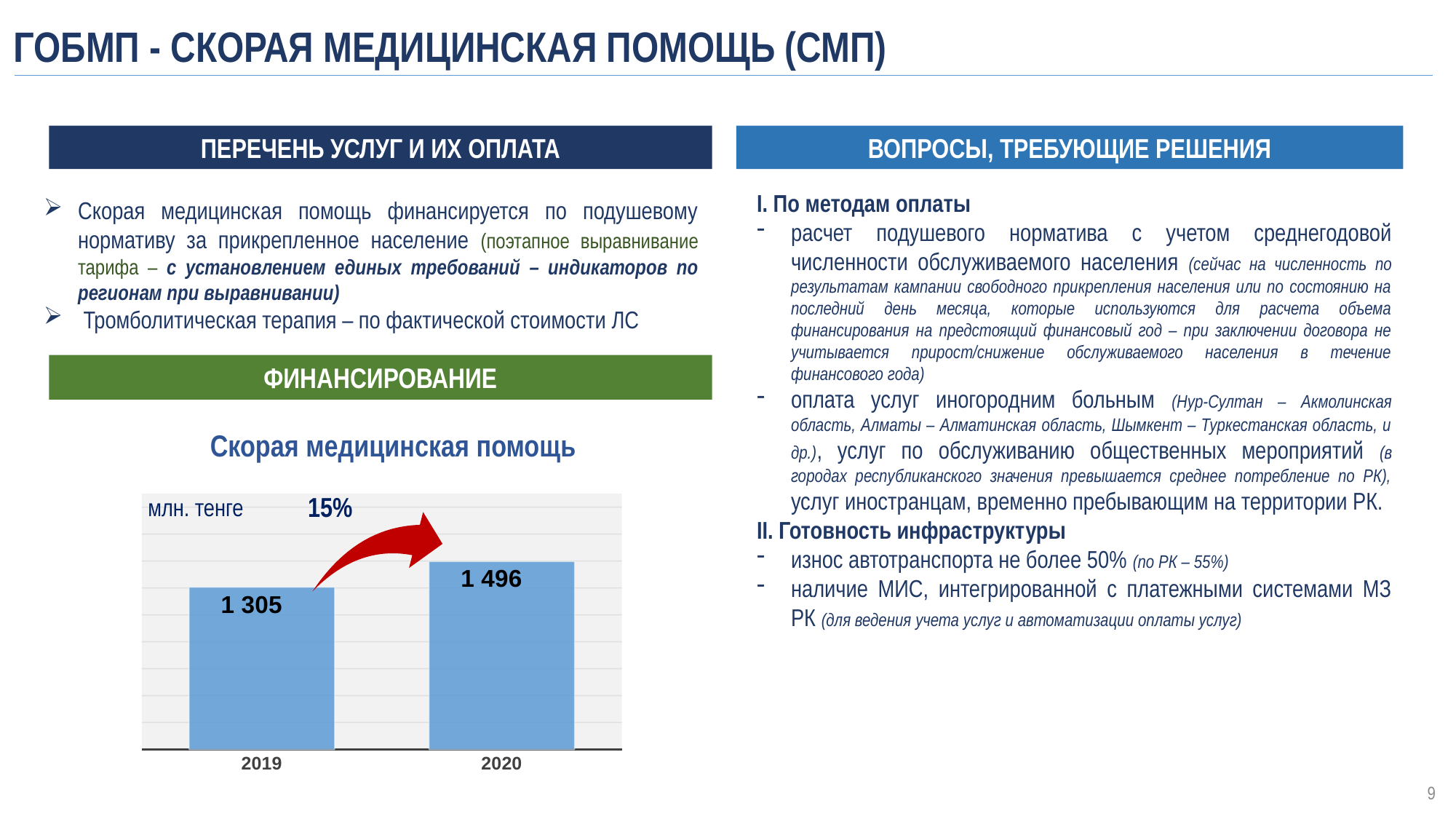
Which year has the lower value in the chart? 2019 What percentage growth is shown next to the arrow in the chart? 15% Is the value for 2020 larger than the value for 2019? Yes What is the difference between the 2020 and 2019 values in the chart? 191 What type of chart is shown on the slide? Bar chart What unit is indicated in the chart? млн. тенге Do the values rise or fall from 2019 to 2020? Rise How many bars are shown in the chart? 2 What is the title of the chart? Скорая медицинская помощь Which year has the higher value in the chart? 2020 What is the value for 2020 in the chart? 1 496 What is the value for 2019 in the chart? 1 305